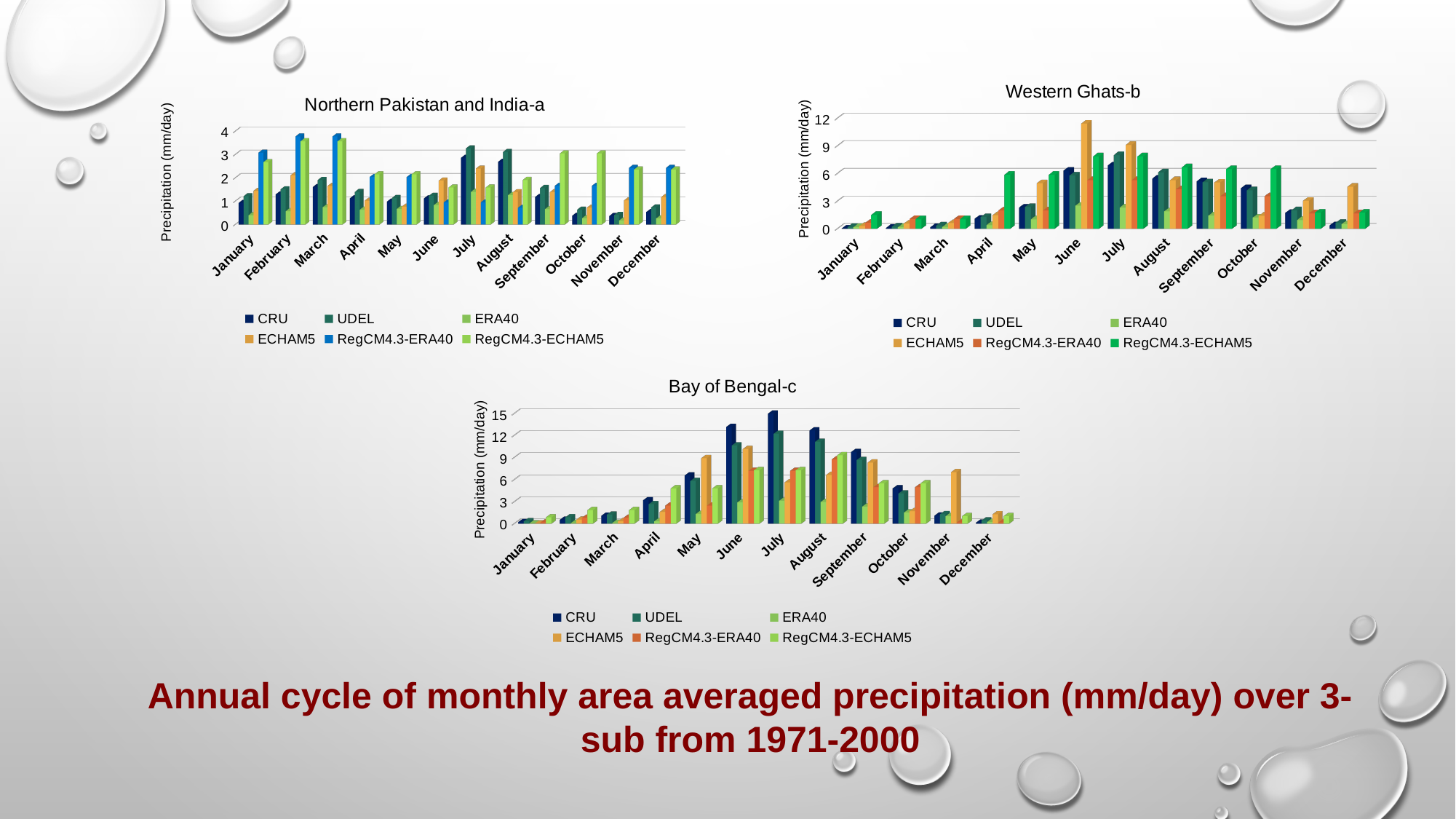
In the Northern Pakistan and India-a chart, is the value for CRU in November greater or less than 1? less How many series does the legend of the Western Ghats-b chart list? 6 In the Northern Pakistan and India-a chart, is the value for RegCM4.3-ERA40 in February greater or less than 3? greater What is the y-axis label of the Western Ghats-b chart? Precipitation (mm/day) In the Western Ghats-b chart, which month has the highest ECHAM5 value? June How many months are shown on the x axis of the Northern Pakistan and India-a chart? 12 In the Bay of Bengal-c chart, do the CRU values rise or fall from January to July? rise In the Bay of Bengal-c chart, is the value for CRU in June greater or less than 12? greater In the Bay of Bengal-c chart, which month has the highest CRU value? July In the Bay of Bengal-c chart, which is larger: the CRU value in July or the CRU value in January? July What kind of chart is the Bay of Bengal-c chart? bar chart